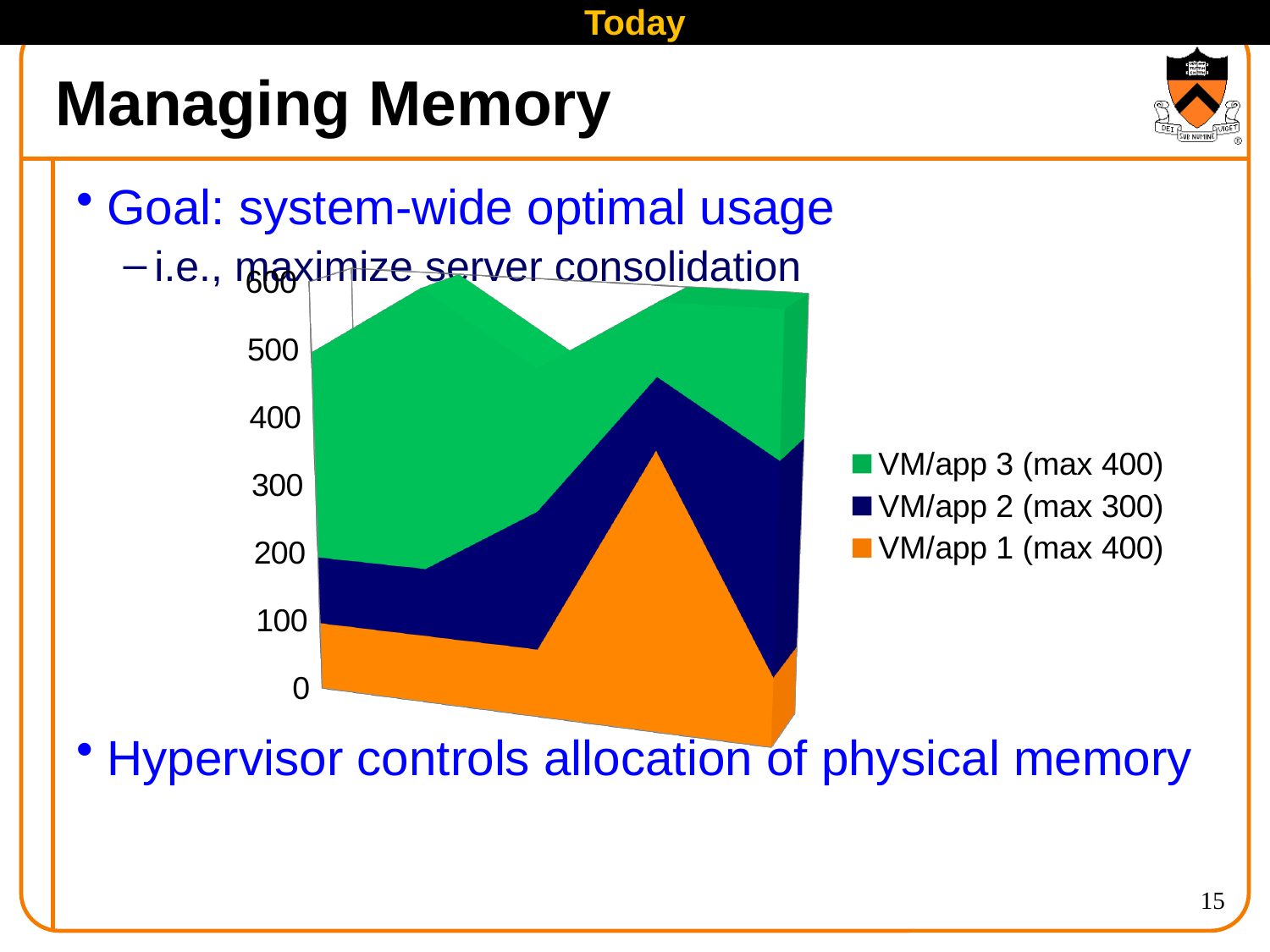
What is the lowest tick value shown on the chart's vertical axis? 0 What kind of chart is shown on the slide? Stacked area chart How many series does the chart's legend list? 3 Which series is shown in green in the chart? VM/app 3 (max 400) Which series is shown in orange in the chart? VM/app 1 (max 400) Is the highest point reached by the top of the stacked area greater or less than 400? greater Is the peak of the orange VM/app 1 area greater or less than 300? greater What is the highest tick value shown on the chart's vertical axis? 600